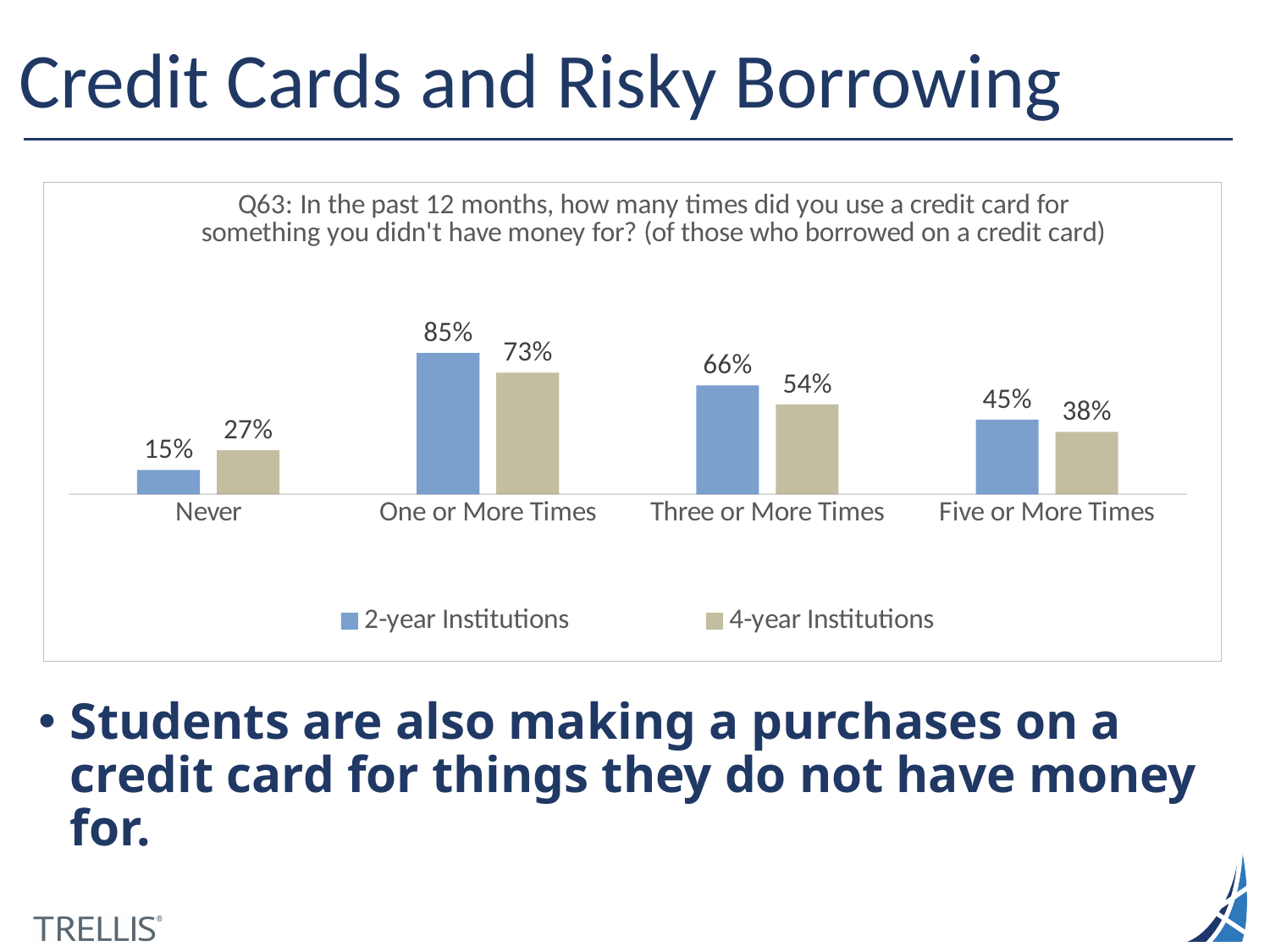
Which series is shown in blue? 2-year Institutions Which category has the lowest value for 4-year Institutions? Never What is the value for 4-year Institutions in the One or More Times category? 73% How many series does the legend list? 2 How many categories are shown on the x axis? 4 Which is larger in the Never category: 2-year Institutions or 4-year Institutions? 4-year Institutions What is the value for 2-year Institutions in the Three or More Times category? 66% What is the difference between 2-year Institutions and 4-year Institutions in the One or More Times category? 12% What is the value for 4-year Institutions in the Five or More Times category? 38% Which category has the highest value for 2-year Institutions? One or More Times What kind of chart is shown on the slide? Bar chart What is the value for 2-year Institutions in the Never category? 15%